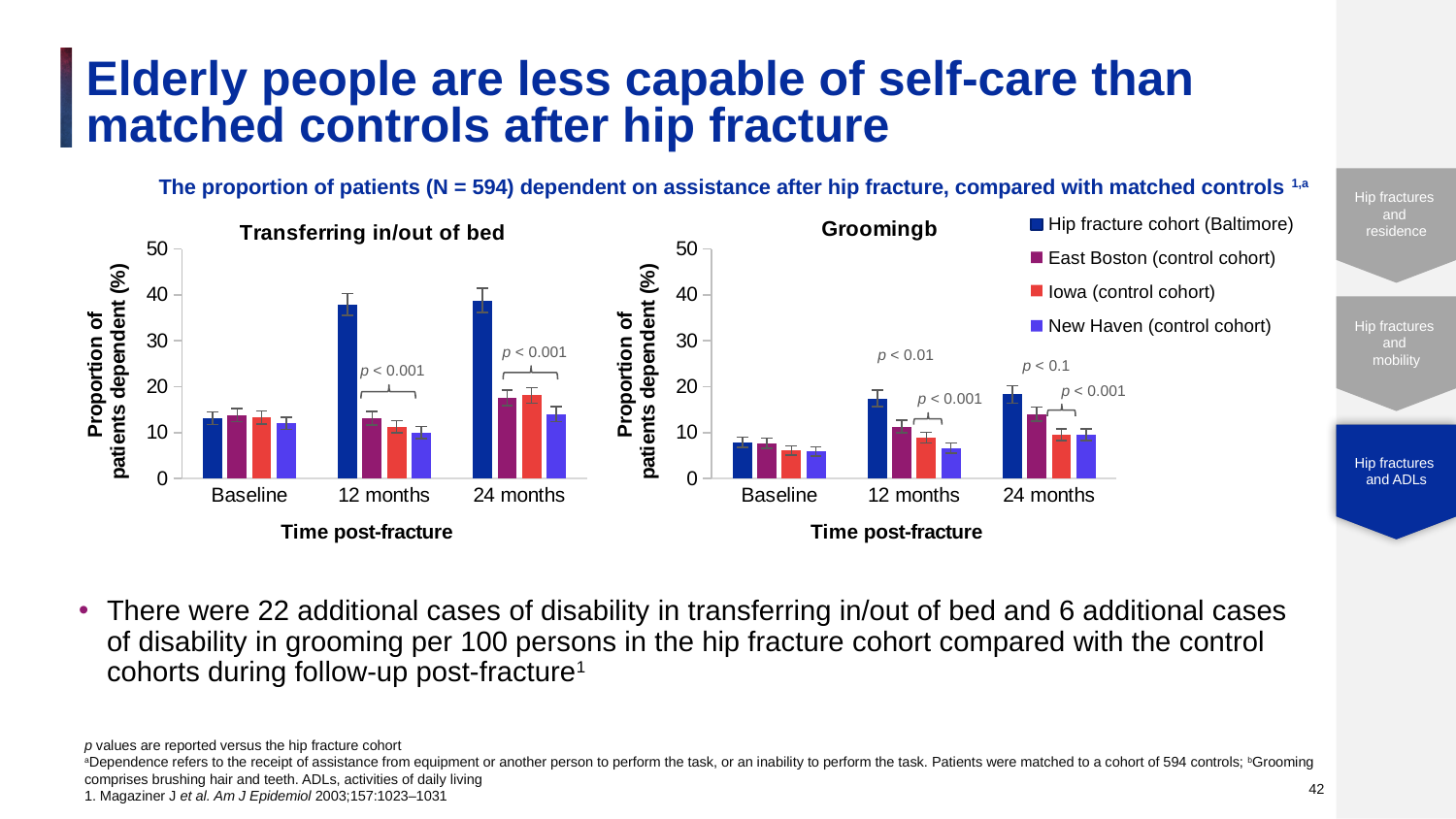
In the 'Transferring in/out of bed' chart, is the value for the hip fracture cohort (Baltimore) at 12 months greater or less than 30? greater In the 'Grooming' chart, is the value for the hip fracture cohort (Baltimore) at 24 months greater or less than 20? less What kind of chart is the 'Transferring in/out of bed' chart? Bar chart In the 'Grooming' chart, how many time-point categories are shown on the x axis? 3 In the 'Grooming' chart, which is larger at 12 months: the hip fracture cohort (Baltimore) or East Boston (control cohort)? Hip fracture cohort (Baltimore) In the 'Transferring in/out of bed' chart, which cohort has the highest value at 24 months? Hip fracture cohort (Baltimore) In the 'Grooming' chart, what p value is shown above the 12 months group for the hip fracture cohort? p < 0.01 In the 'Transferring in/out of bed' chart, is the value for New Haven (control cohort) at 12 months greater or less than 20? less How many series does the legend list for the charts? 4 In the 'Transferring in/out of bed' chart, does the value for the hip fracture cohort (Baltimore) rise or fall from baseline to 12 months? rise In the 'Grooming' chart, which cohort has the lowest value at 12 months? New Haven (control cohort) What is the y-axis label on the 'Grooming' chart? Proportion of patients dependent (%)